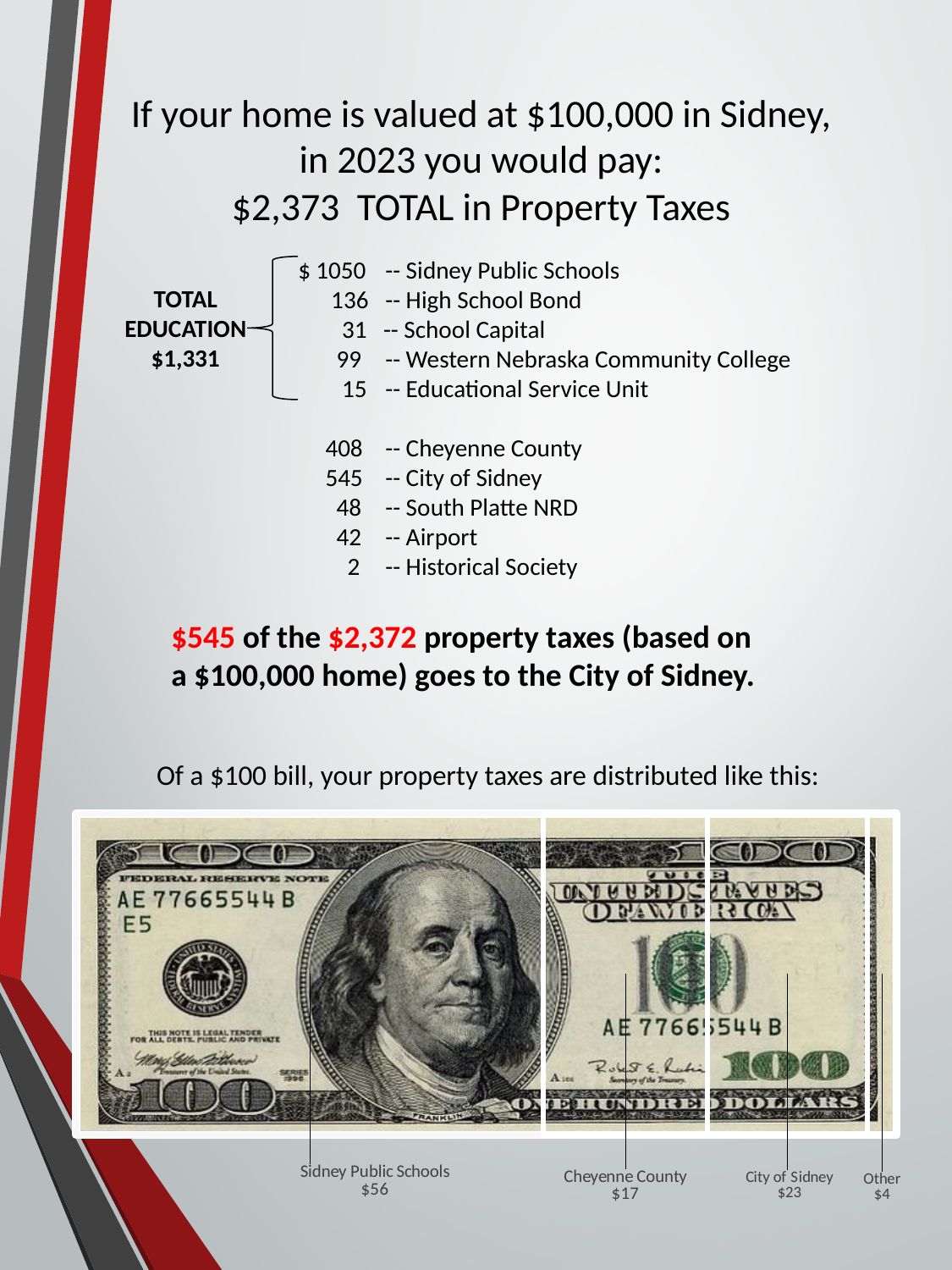
In the $100 bill graphic, which receives more: Cheyenne County or City of Sidney? City of Sidney In the $100 bill graphic, what is the difference between the Sidney Public Schools amount and the City of Sidney amount? $33 In the $100 bill graphic, what share of the $100 bill goes to Sidney Public Schools? 56% In the $100 bill graphic, how much goes to Cheyenne County? $17 How many labelled segments is the $100 bill graphic divided into? 4 In the $100 bill graphic, which segment receives the smallest amount? Other In the $100 bill graphic, which segment receives the largest amount? Sidney Public Schools In the $100 bill graphic, how much goes to the City of Sidney? $23 In the $100 bill graphic, how much goes to Other? $4 In the $100 bill graphic at the bottom of the slide, how much goes to Sidney Public Schools? $56 What image is used to show how property taxes are distributed on the slide? A $100 bill divided into segments In the $100 bill graphic, what is the combined amount for Cheyenne County and City of Sidney? $40